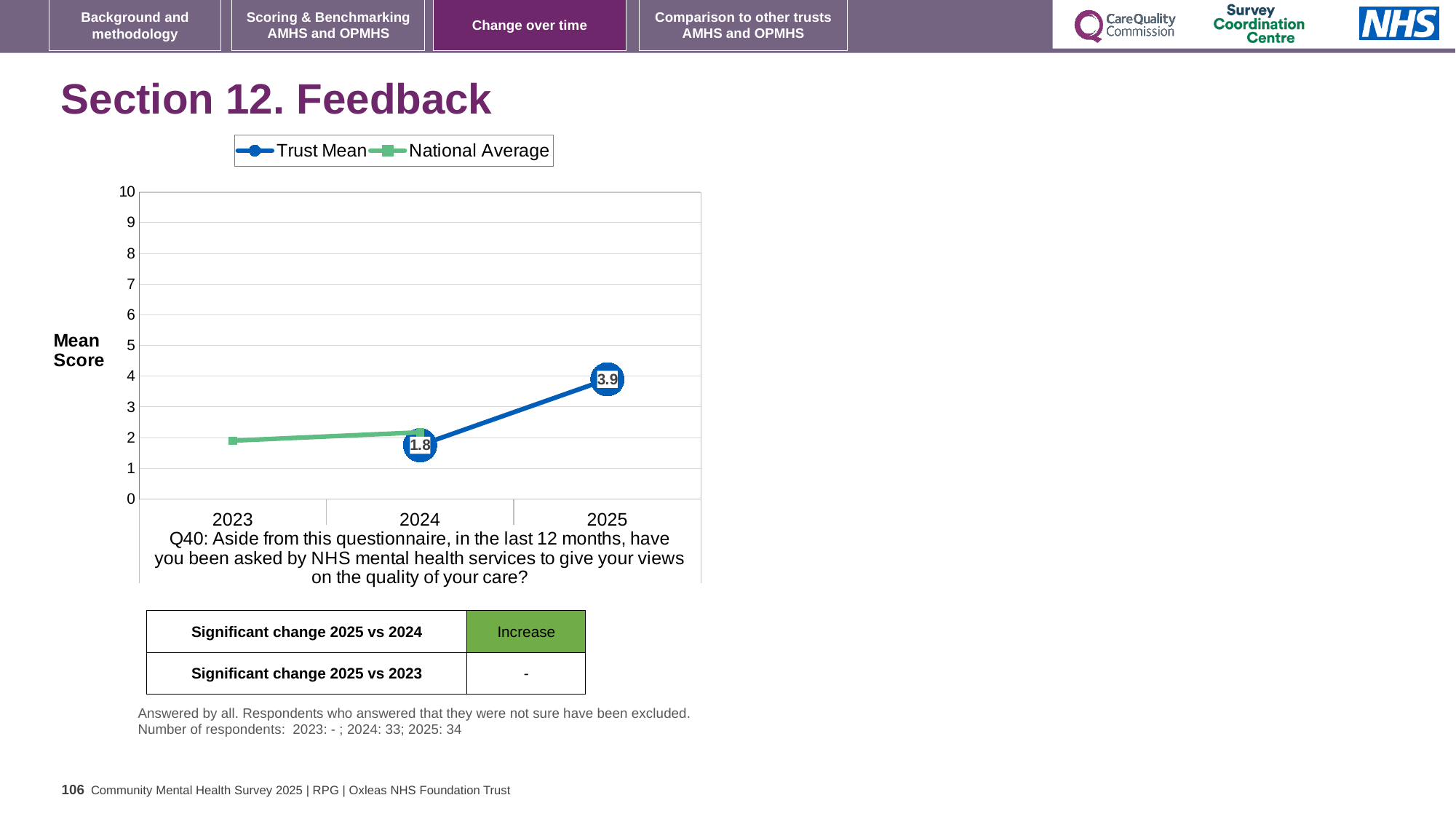
What is the Trust Mean value for 2024? 1.8 Does the Trust Mean rise or fall from 2024 to 2025? Rise What are the two series named in the legend? Trust Mean and National Average How many series does the legend list? 2 How many years are shown on the x axis? 3 Is the Trust Mean value for 2025 greater or less than 3? greater In which year is the Trust Mean highest? 2025 What kind of chart is shown on the slide? Line chart Which year has the higher Trust Mean, 2024 or 2025? 2025 Is the National Average value for 2023 greater or less than 5? less What is the Trust Mean value for 2025? 3.9 What is the difference between the Trust Mean in 2025 and the Trust Mean in 2024? 2.1